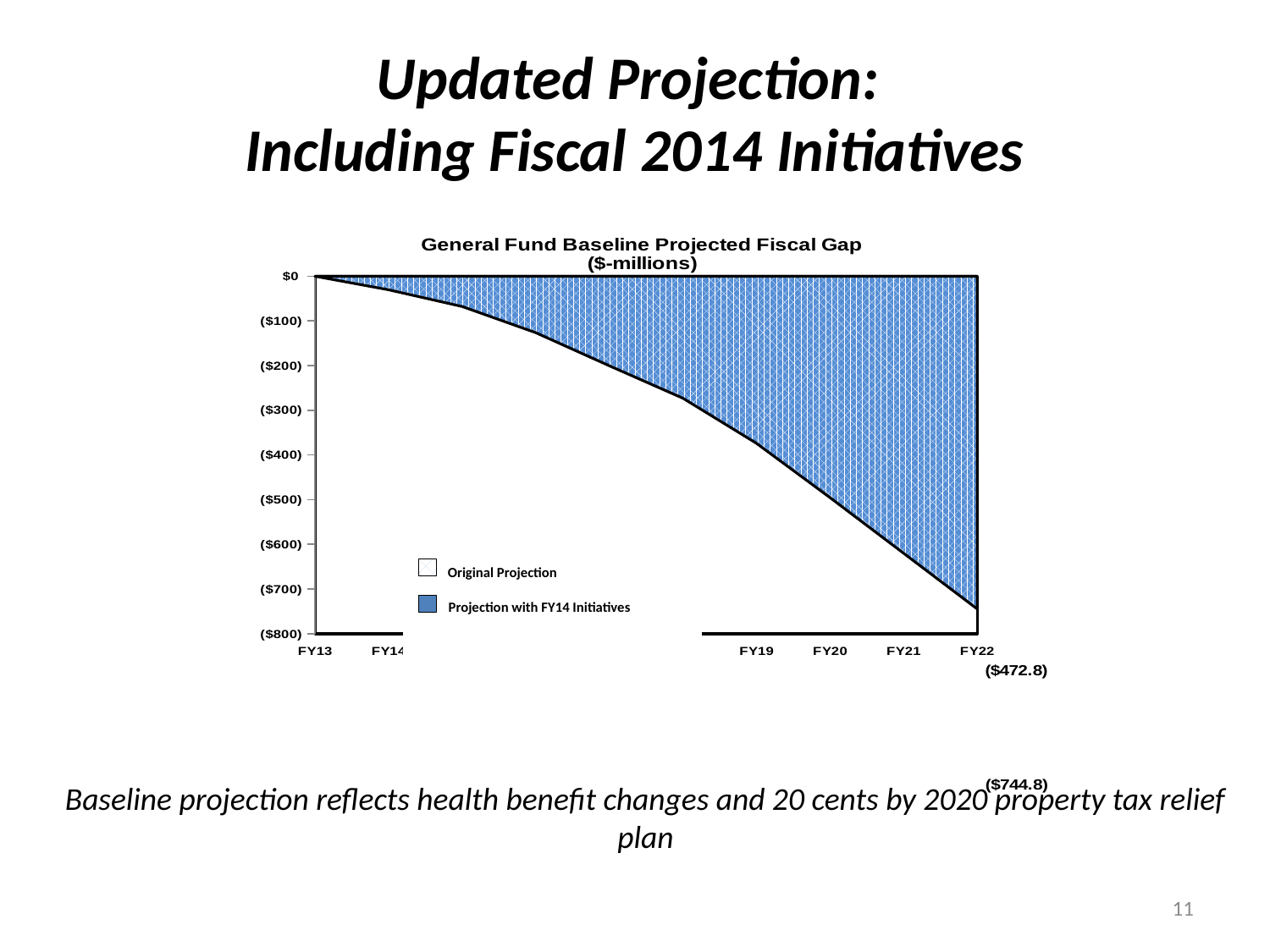
Which fiscal year shows the smallest projected fiscal gap? FY13 What is the plotted value at FY22? ($744.8) What kind of chart is shown on the slide? Area chart Is the plotted value at FY21 greater or less than ($700)? greater What is the plotted value at FY13? $0 What is the title of the chart? General Fund Baseline Projected Fiscal Gap ($-millions) Which fiscal year shows the largest projected fiscal gap? FY22 Is the plotted value at FY14 greater or less than ($100)? greater Do the plotted values rise or fall from FY13 to FY22? Fall Is the projected gap at FY22 larger than the gap at FY19? Yes What are the two series named in the legend? Original Projection; Projection with FY14 Initiatives How many series does the chart legend list? 2